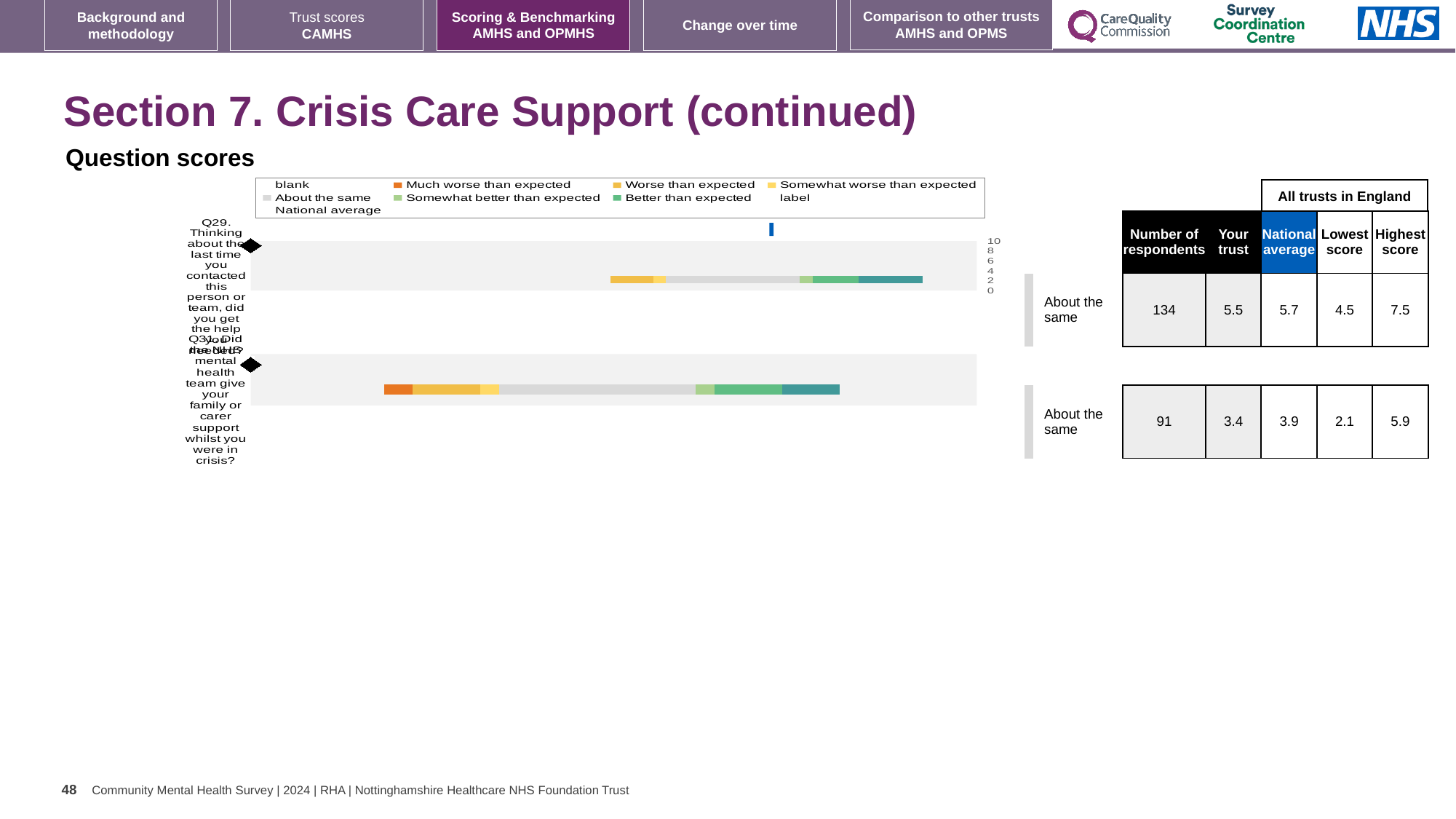
In the table beside the chart, what is the 'Your trust' score for Q31? 3.4 In the table beside the chart, what is the national average for Q29? 5.7 For Q31, what is the difference between the national average and the 'Your trust' score? 0.5 How many questions are plotted as bars in the question scores chart? 2 In the table beside the chart, how many respondents are shown for Q29? 134 Which question has the larger number of respondents, Q29 or Q31? Q29 For Q29, which is larger: the 'Your trust' score or the national average? National average For Q29, what is the difference between the highest score and the lowest score in the table? 3.0 In the chart legend, what colour is used for 'Much worse than expected'? orange What benchmark category label is shown next to both Q29 and Q31? About the same What kind of chart is used to show the question scores on this slide? bar chart In the table beside the chart, what is the highest score for Q31? 5.9